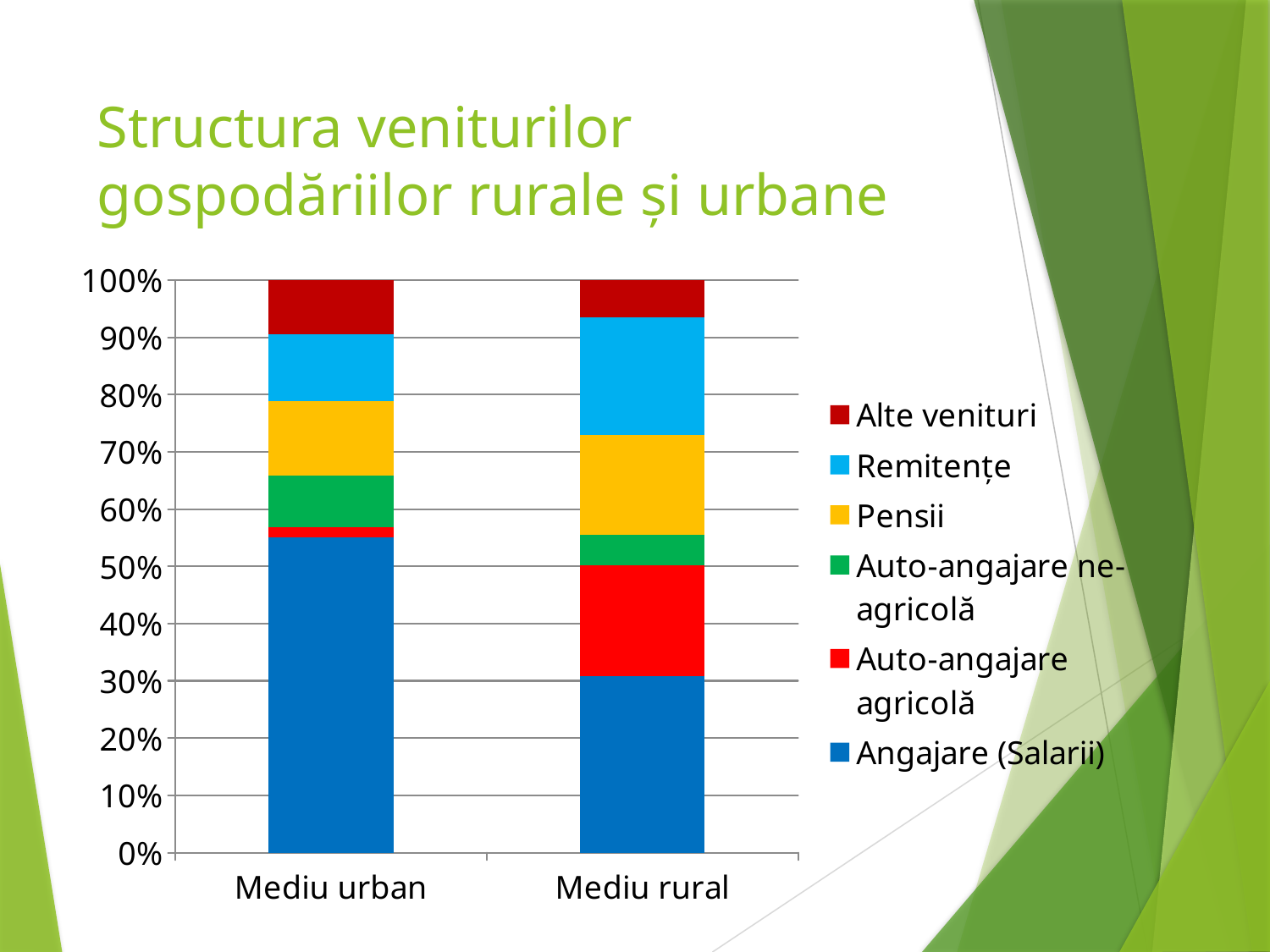
Is the share of Angajare (Salarii) for Mediu rural greater or less than 40%? less Is the share of Auto-angajare agricolă for Mediu rural greater or less than 10%? greater Which category has the larger share of Angajare (Salarii), Mediu urban or Mediu rural? Mediu urban Which series makes up the largest segment of the Mediu rural bar? Angajare (Salarii) How many series does the chart's legend list? 6 Which legend entry is shown in dark blue? Angajare (Salarii) Is the share of Angajare (Salarii) for Mediu urban greater or less than 50%? greater What is the title of the slide containing the chart? Structura veniturilor gospodăriilor rurale și urbane What is the total height of the Mediu urban stacked bar? 100% How many categories are shown on the x axis of the chart? 2 Which category has the larger share of Auto-angajare agricolă, Mediu urban or Mediu rural? Mediu rural What kind of chart is shown on the slide? Stacked bar chart